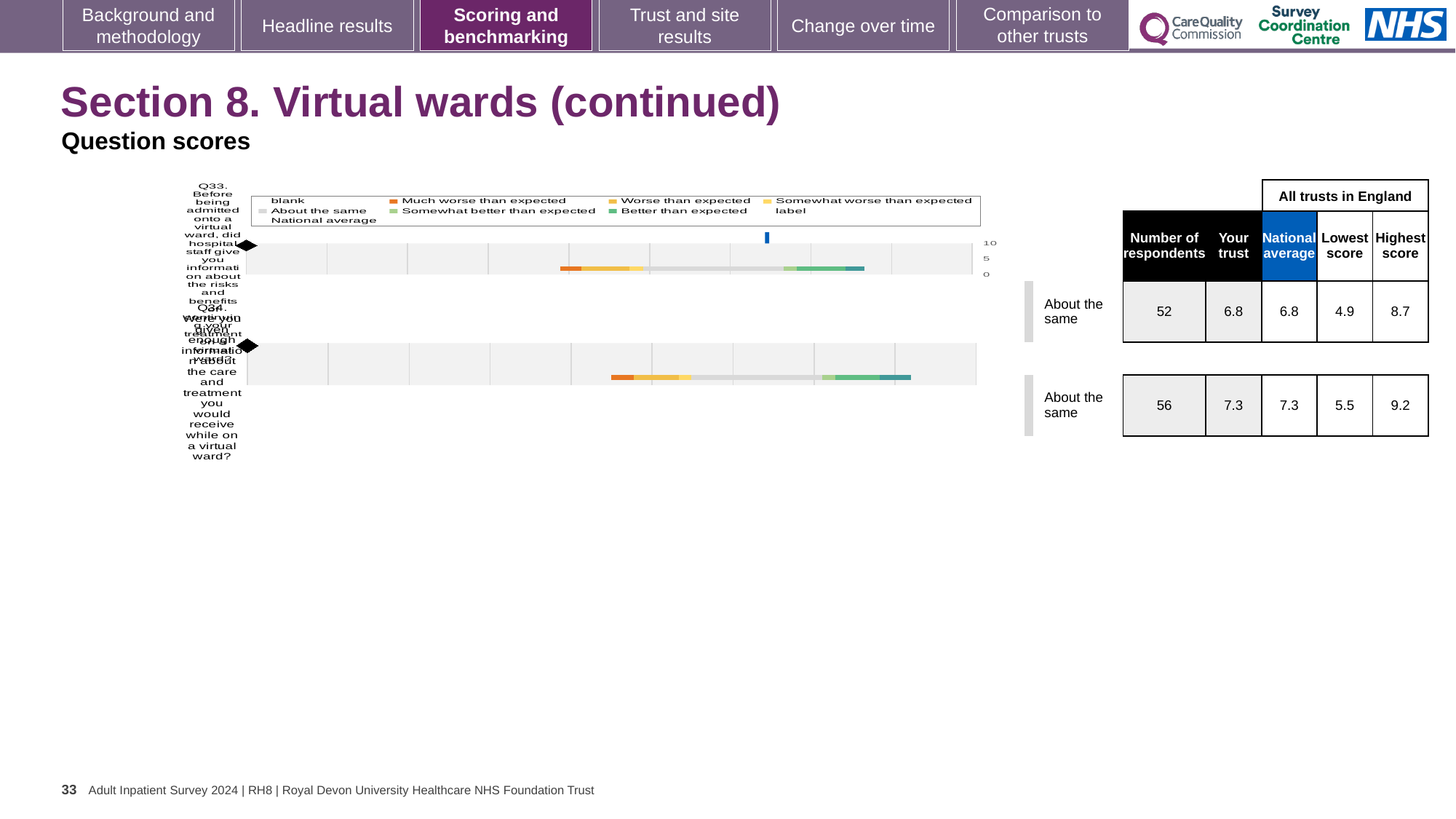
Which colour does the chart legend use for 'Much worse than expected'? orange What kind of chart is shown on the slide? bar chart Which colour does the chart legend use for 'Better than expected'? green In the table beside the chart, what is the 'Your trust' score for Q33? 6.8 In the table beside the chart, how many respondents answered Q34? 56 In the table beside the chart, what is the highest score across all trusts in England for Q33? 8.7 In the table beside the chart, what is the 'Your trust' score for Q34? 7.3 How many questions (categories) are plotted in the chart? 2 In the table beside the chart, what is the lowest score across all trusts in England for Q34? 5.5 What benchmark category is shown for Q33 next to the chart? About the same Which question has the higher 'Your trust' score, Q33 or Q34? Q34 What is the difference between the highest and lowest scores for Q33 in the table beside the chart? 3.8